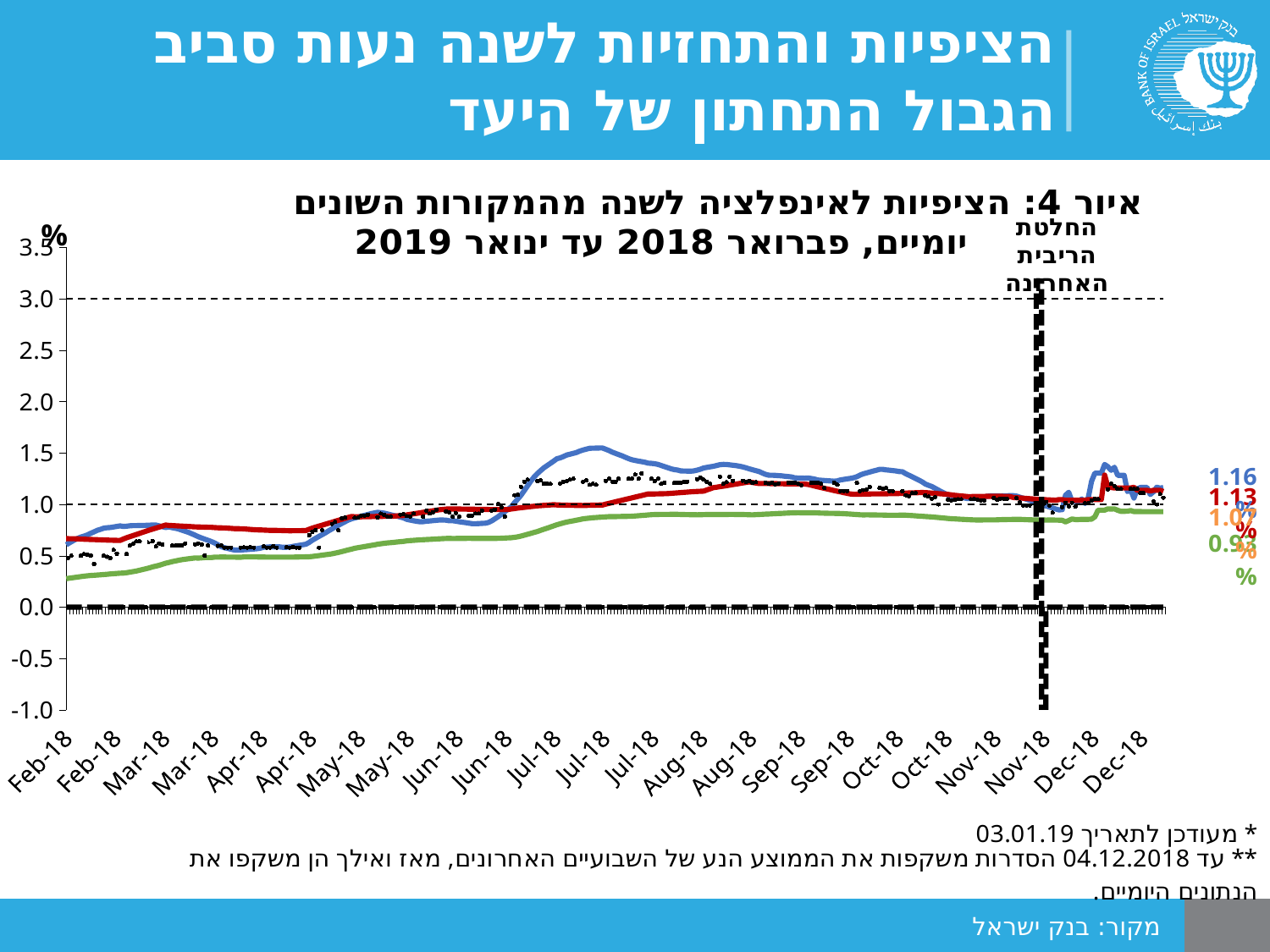
What is the difference between the labelled end values of the blue line (1.16) and the green line (0.93)? 0.23 What is the final value labelled for the green line at the right edge of the chart? 0.93 How many data lines are plotted on the chart? 4 Does the green line generally rise or fall from Feb-18 to Dec-18? rise What kind of chart is shown on the slide? line chart Which line has the highest labelled end value at the right edge of the chart? the blue line (1.16) At what two values on the y axis are the horizontal dashed lines drawn? 1.0 and 3.0 Which line has the lowest labelled end value at the right edge of the chart? the green line (0.93) Is the value of the green line at the start of the chart (Feb-18) greater or less than 0.5? less What is the final value labelled for the red line at the right edge of the chart? 1.13 Is the value of the blue line around Jul-18 greater or less than 1.0? greater What is the final value labelled for the blue line at the right edge of the chart? 1.16